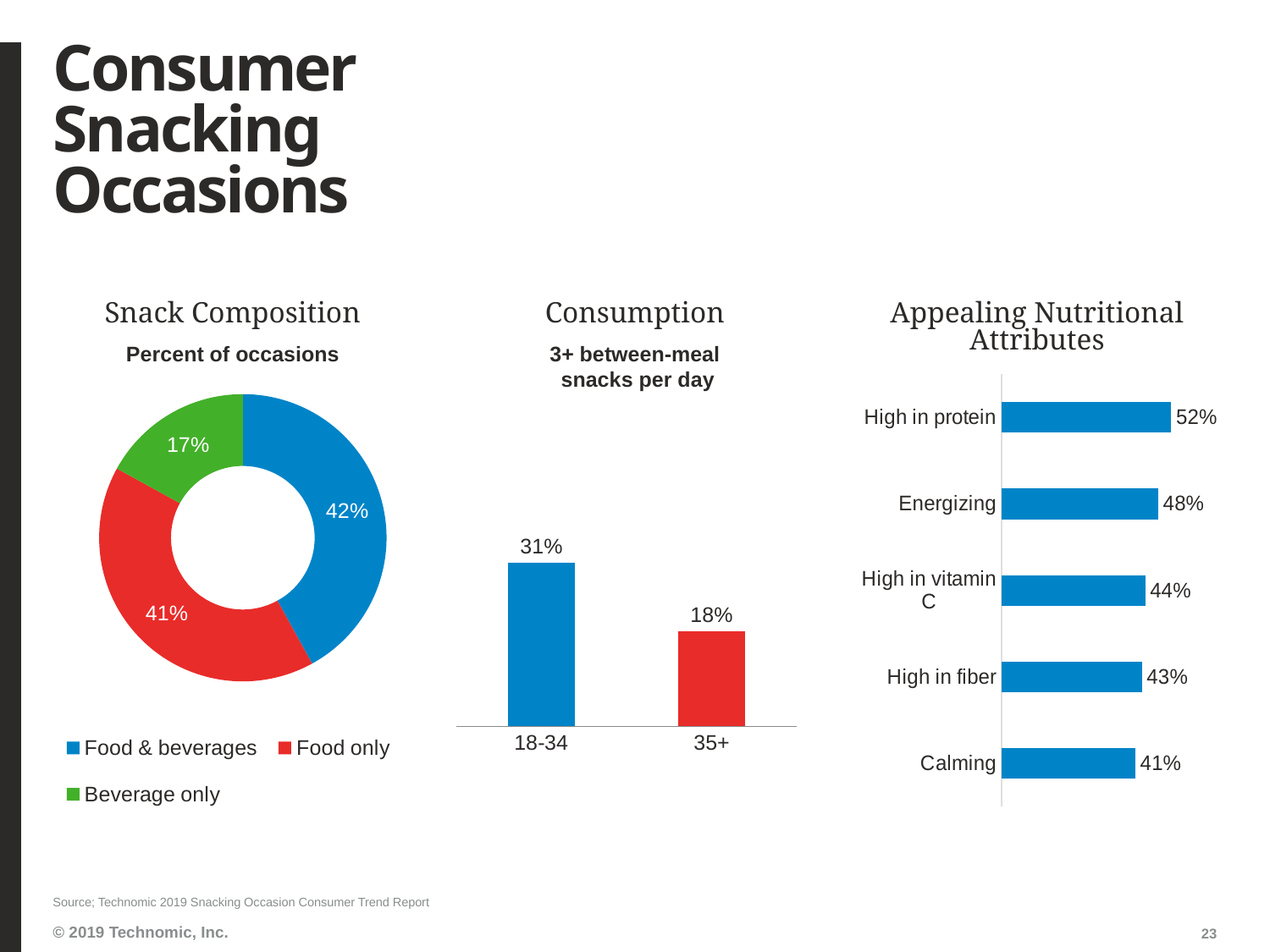
How many categories does the legend of the Snack Composition chart list? 3 What kind of chart is the Snack Composition chart? Doughnut chart In the Snack Composition chart, what percent of occasions are Food only? 41% In the Snack Composition chart, which category has the smallest share of occasions? Beverage only In the Consumption chart, what percent of the 18-34 group eats 3+ between-meal snacks per day? 31% In the Consumption chart, which age group has the higher value, 18-34 or 35+? 18-34 In the Consumption chart, what is the difference between the 18-34 and 35+ values? 13% In the Appealing Nutritional Attributes chart, what is the value for High in vitamin C? 44% How many attributes are shown in the Appealing Nutritional Attributes chart? 5 In the Appealing Nutritional Attributes chart, which attribute has the highest value? High in protein In the Snack Composition chart, what share of occasions is Food & beverages? 42% In the Appealing Nutritional Attributes chart, what is the difference between Energizing and Calming? 7%